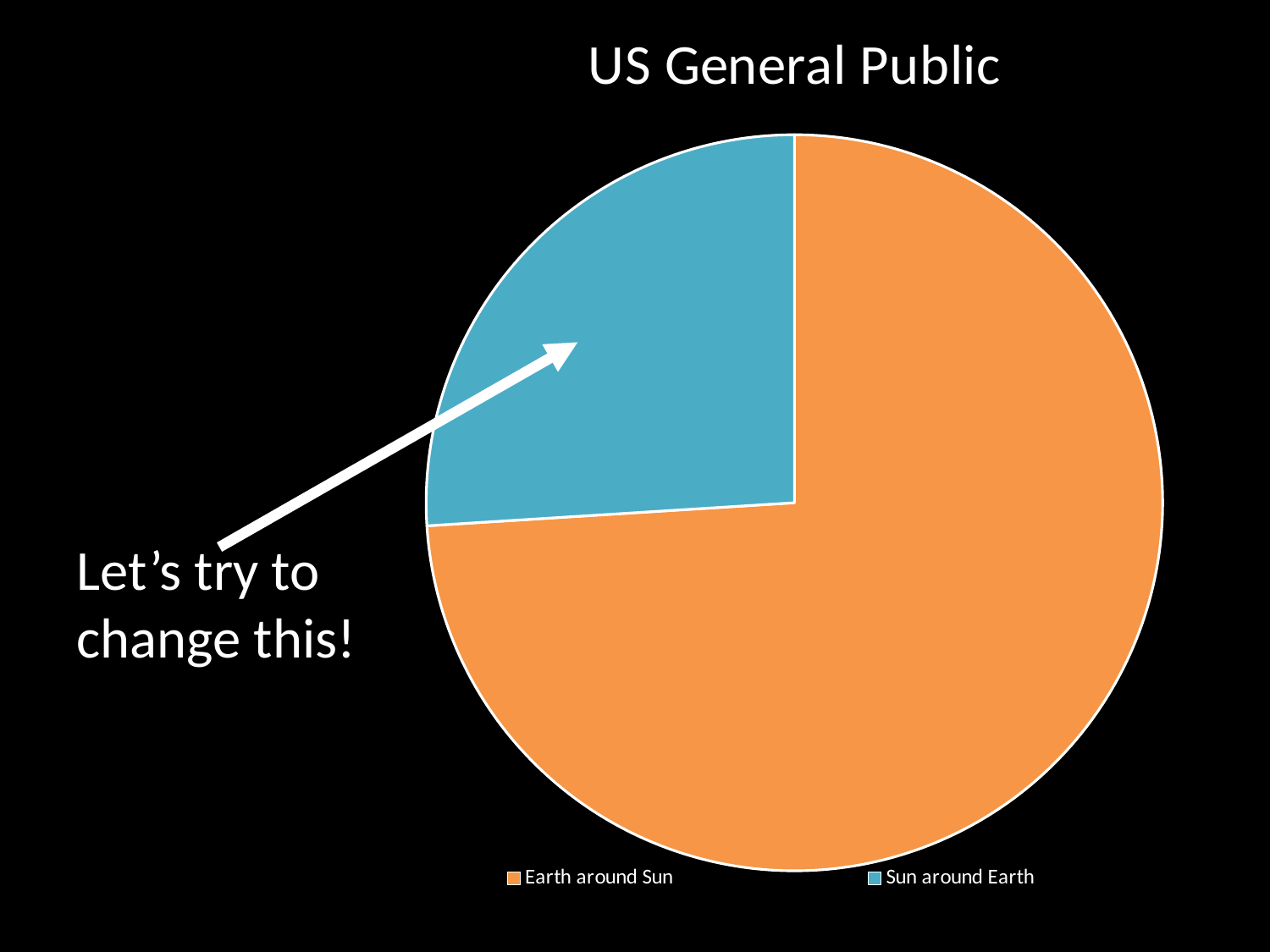
Which slice does the white arrow point to? Sun around Earth How many entries does the legend list? 2 How many slices does the pie chart have? 2 Which slice is the largest in the pie chart? Earth around Sun What is the title of the chart? US General Public Which is larger, the Earth around Sun slice or the Sun around Earth slice? Earth around Sun What kind of chart is shown on the slide? pie chart Which slice is the smallest in the pie chart? Sun around Earth What colour is the Sun around Earth slice? blue